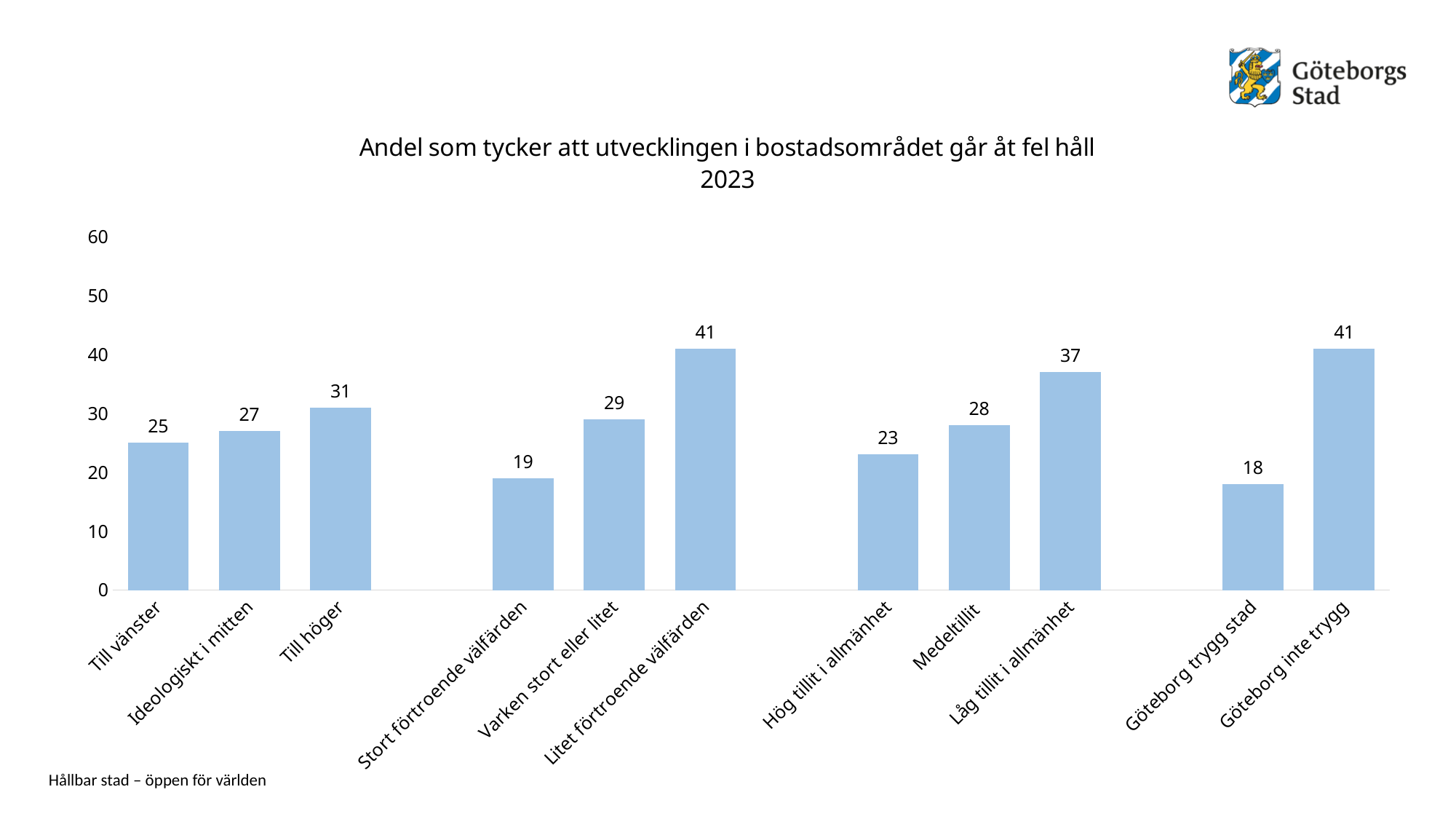
How many categories are shown in the chart? 11 What is the value for Stort förtroende välfärden? 19 What is the difference between the values for Göteborg inte trygg and Göteborg trygg stad? 23 What year is shown in the chart title? 2023 What is the value for Låg tillit i allmänhet? 37 What is the value for Göteborg inte trygg? 41 Which is larger, the value for Medeltillit or the value for Hög tillit i allmänhet? Medeltillit Is the value for Litet förtroende välfärden greater or less than 30? greater What is the value for Till vänster? 25 What kind of chart is shown on the slide? bar chart Which category has the lowest value? Göteborg trygg stad What is the difference between the values for Till höger and Till vänster? 6